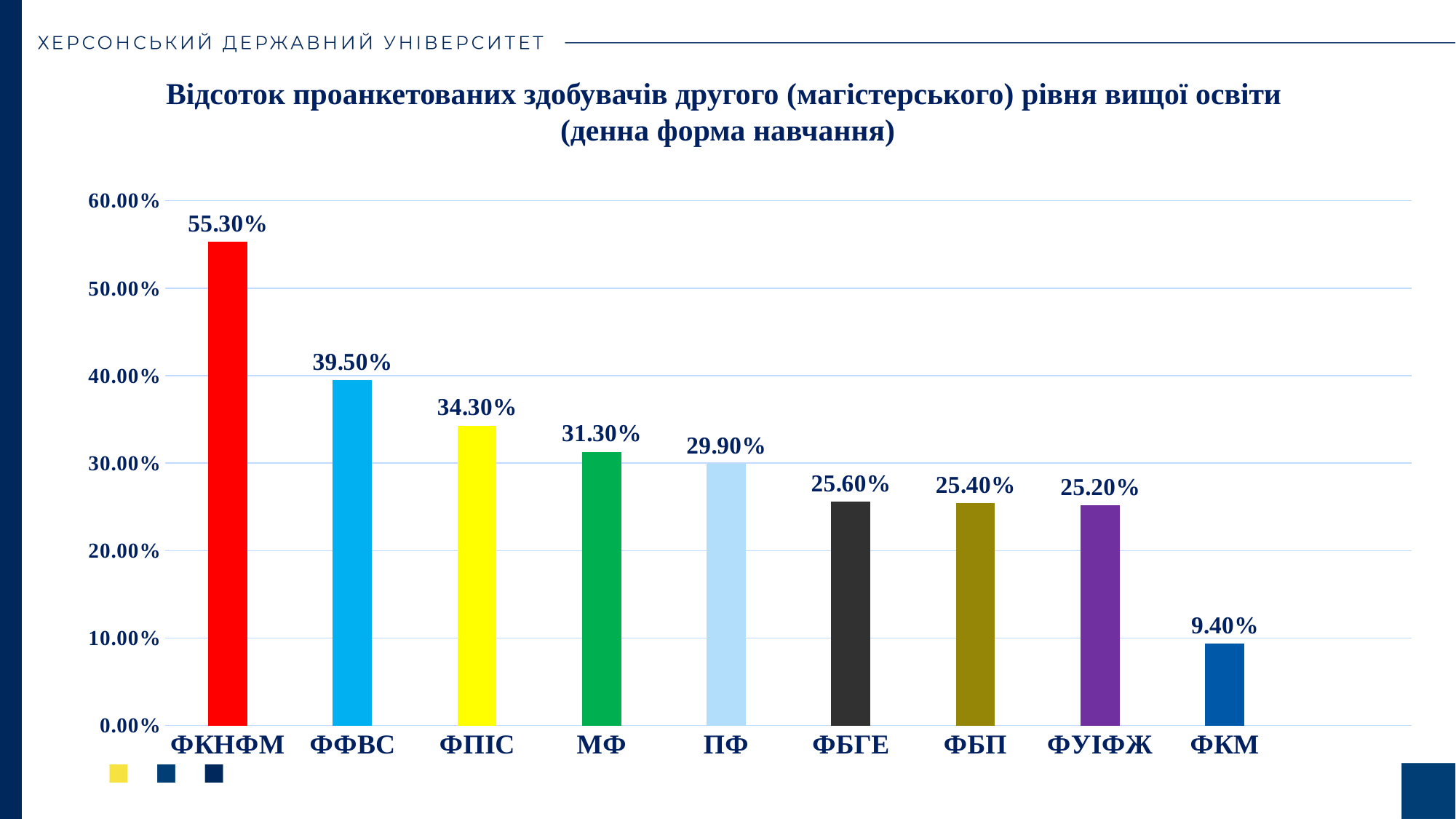
Is the value for ФБП greater or less than 30.00%? less Which category has the highest value? ФКНФМ Which is larger, the value for ФПІС or the value for ФБГЕ? ФПІС What is the value for ФУІФЖ? 25.20% Do the values rise or fall from left to right along the x axis? fall What kind of chart is shown on the slide? bar chart What is the difference between the values for МФ and ФКМ? 21.90% What is the value for ФКНФМ? 55.30% Which category has the lowest value? ФКМ How many categories are shown on the x axis? 9 What is the value for ПФ? 29.90% What is the difference between the values for ФКНФМ and ФФВС? 15.80%